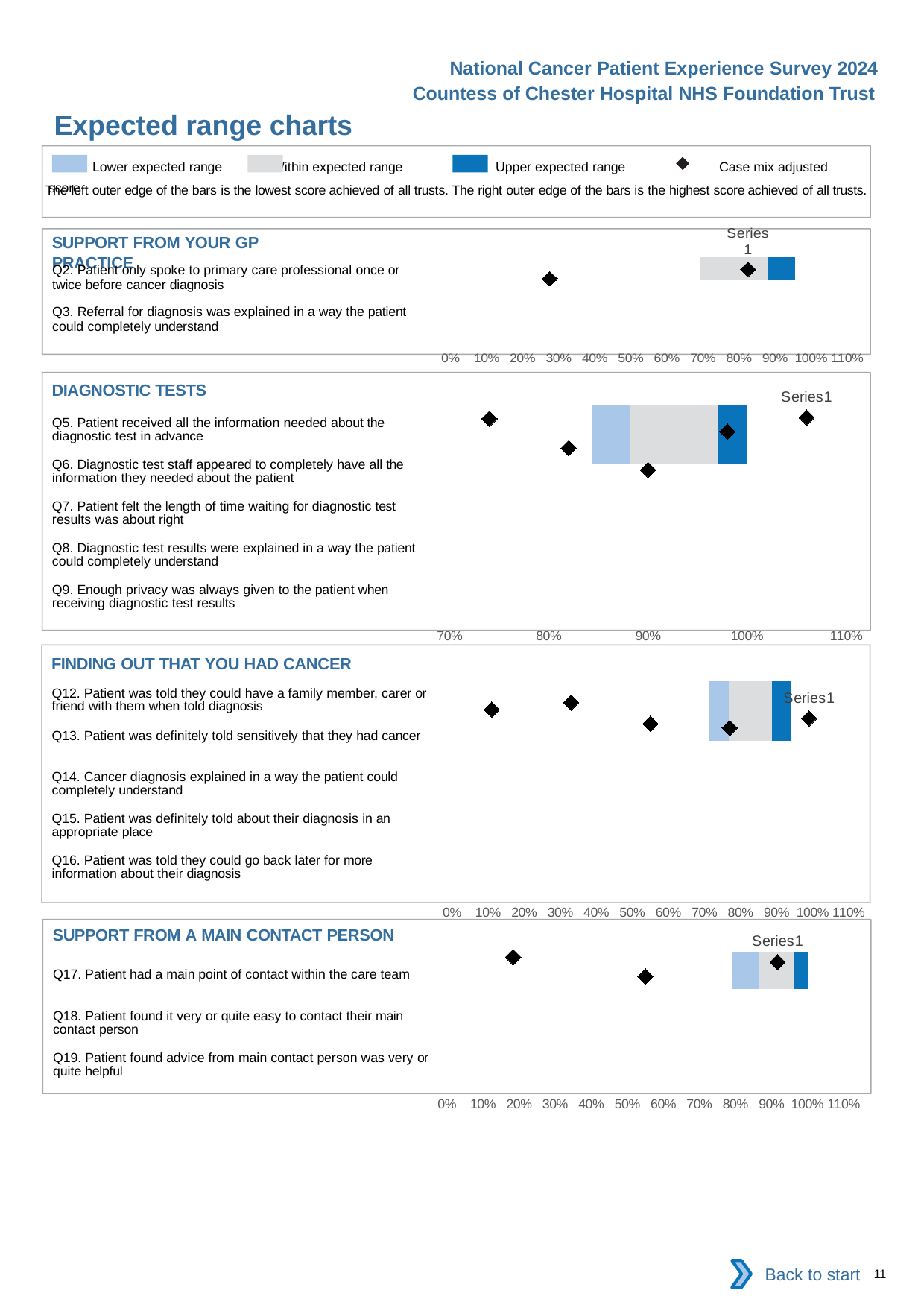
How many questions are listed in the 'DIAGNOSTIC TESTS' chart? 5 In the 'SUPPORT FROM A MAIN CONTACT PERSON' chart, is the leftmost diamond marker greater or less than 30%? less How many questions are listed in the 'FINDING OUT THAT YOU HAD CANCER' chart? 5 In the 'DIAGNOSTIC TESTS' chart, is the rightmost diamond marker greater or less than 100%? greater What kind of chart is used in the 'DIAGNOSTIC TESTS' section? bar chart According to the legend at the top of the slide, what does the diamond marker represent? Case mix adjusted score How many diamond markers are plotted in the 'FINDING OUT THAT YOU HAD CANCER' chart? 5 According to the legend at the top of the slide, what does the light blue colour represent? Lower expected range In the 'DIAGNOSTIC TESTS' chart, is the leftmost diamond marker greater or less than 80%? less